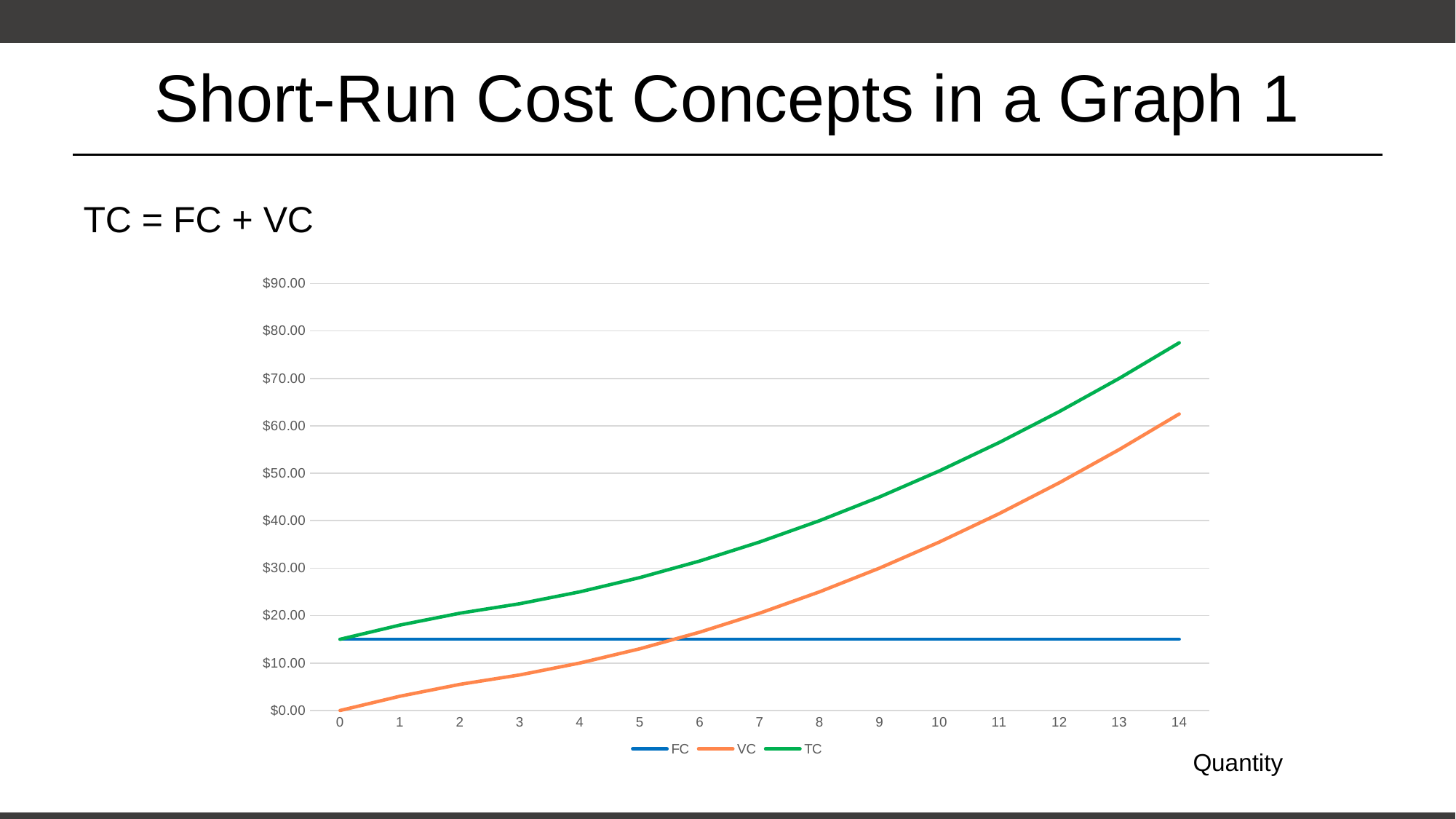
Which series has the lowest value at quantity 14? FC Which series has the highest value at quantity 14? TC Is the value of TC at quantity 14 greater or less than $70.00? greater What label is shown for the x axis of the chart? Quantity Does the FC line rise, fall, or stay flat as quantity increases? stays flat How many series does the chart's legend list? 3 Is the value of VC at quantity 14 greater or less than $70.00? less Does the VC line rise or fall as quantity increases? rises What kind of chart is shown on the slide? line chart Is the value of FC at quantity 10 greater or less than $20.00? less What is the value of VC at quantity 0? $0.00 How many quantity values are plotted along the x axis? 15